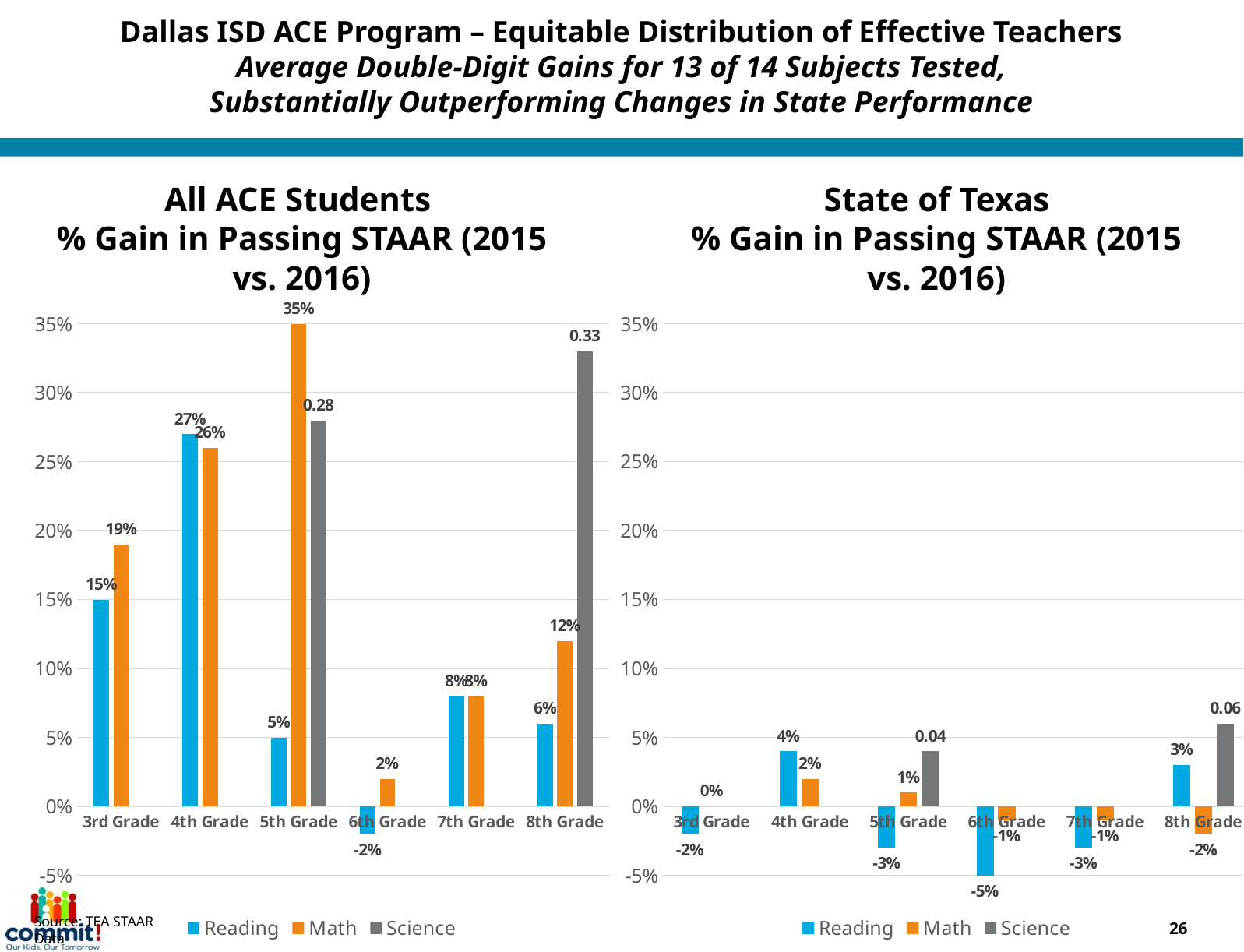
In the All ACE Students chart, what is the Math value for 5th Grade? 35% In the All ACE Students chart, which series is shown in orange? Math In the All ACE Students chart, which grade has the highest Math value? 5th Grade What kind of chart is the All ACE Students chart? Bar chart In the All ACE Students chart, what is the difference between the Math and Reading values for 3rd Grade? 4% In the State of Texas chart, what is the Science value for 8th Grade? 0.06 How many series does the legend of the State of Texas chart list? 3 In the All ACE Students chart, what is the Reading value for 6th Grade? -2% In the State of Texas chart, which grade has the lowest Reading value? 6th Grade In the State of Texas chart, what is the Reading value for 4th Grade? 4% In the All ACE Students chart, what is the Reading value for 4th Grade? 27% How many grade categories are shown on the x axis of the All ACE Students chart? 6